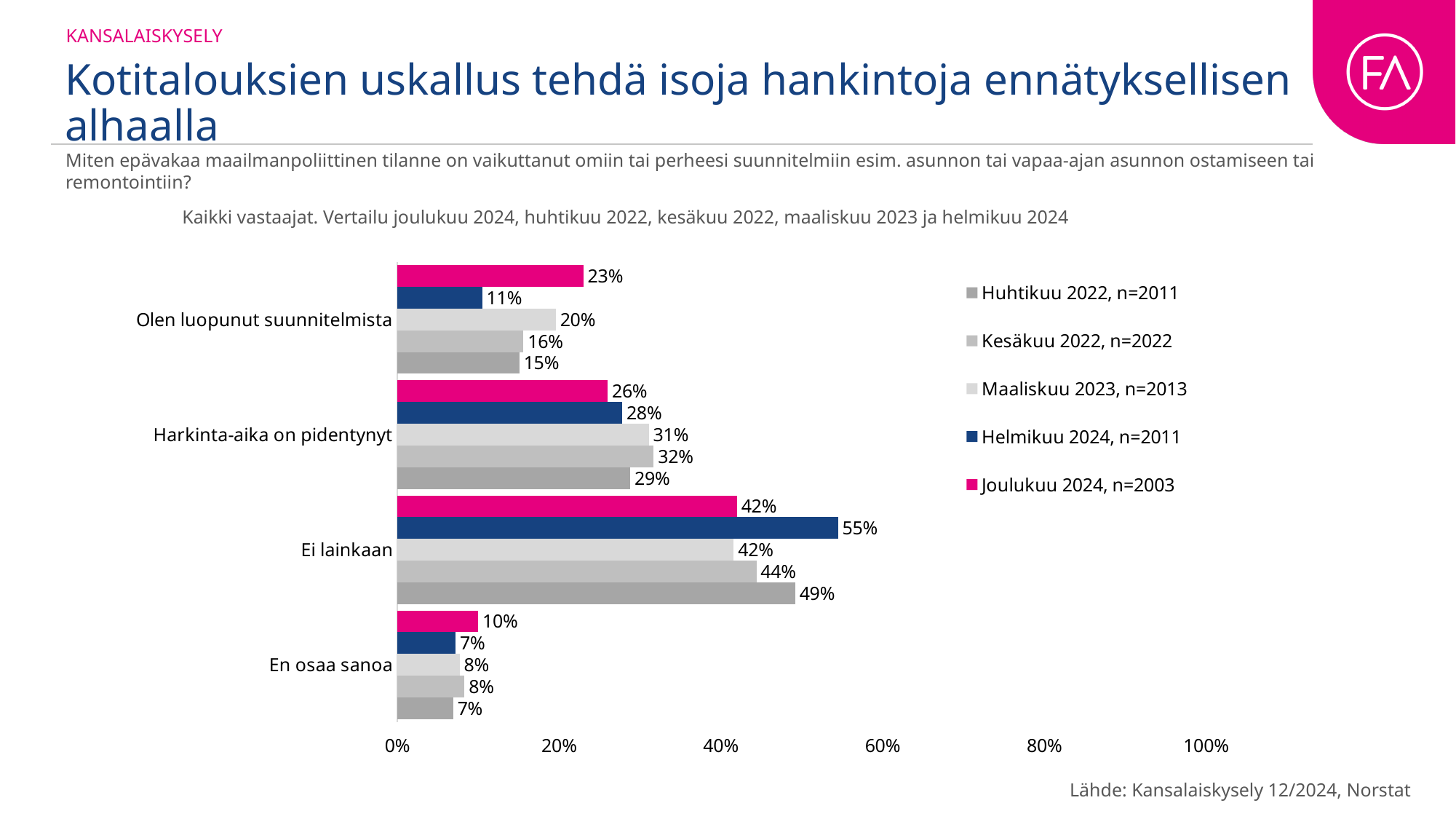
Is the Huhtikuu 2022 value for "Ei lainkaan" greater or less than 40%? greater What is the difference between the Joulukuu 2024 and Helmikuu 2024 values for "Olen luopunut suunnitelmista"? 12 percentage points How many categories are shown on the chart? 4 Which category has the highest value in the Joulukuu 2024 series? Ei lainkaan For "Ei lainkaan", which is larger: the Helmikuu 2024 value or the Joulukuu 2024 value? Helmikuu 2024 Which category has the lowest value in the Helmikuu 2024 series? En osaa sanoa What is the value for "Ei lainkaan" in the Helmikuu 2024 series? 55% What is the value for "Harkinta-aika on pidentynyt" in the Kesäkuu 2022 series? 32% How many series does the legend list? 5 What is the value for "Olen luopunut suunnitelmista" in the Joulukuu 2024 series? 23% What is the value for "En osaa sanoa" in the Huhtikuu 2022 series? 7% What kind of chart is shown on the slide? Bar chart